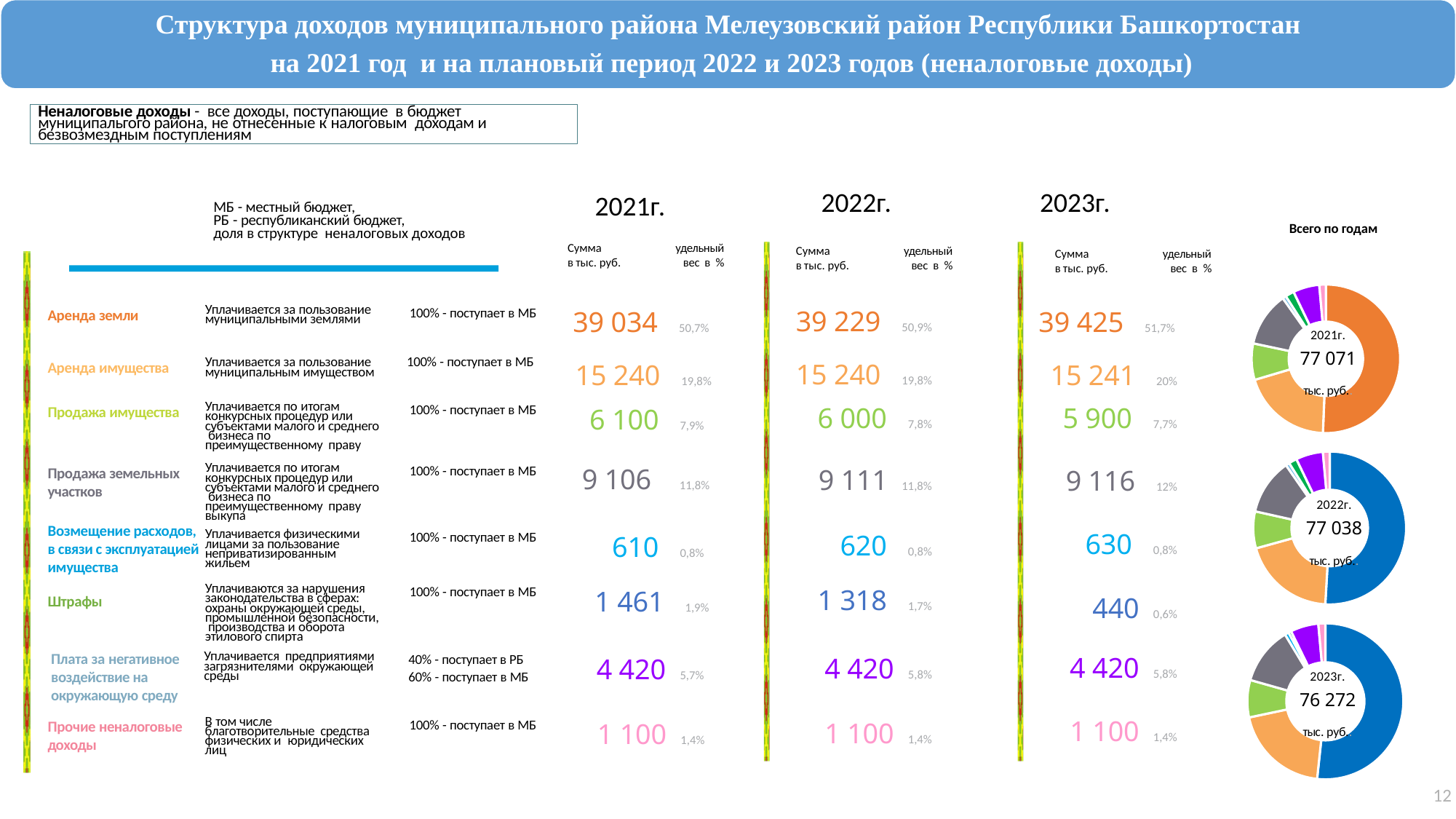
What is the difference between the centre totals of the 2021г. and 2023г. donut charts? 799 How many donut charts are shown under 'Всего по годам'? 3 In the 2021г. donut chart, which revenue category does the largest (orange) slice represent, according to the table? Аренда земли Is the centre total of the 2022г. donut chart greater or less than the centre total of the 2023г. donut chart? greater What kind of chart is used in the 'Всего по годам' section on the right of the slide? Pie (donut) chart What share of non-tax revenue does 'Аренда земли' make up in 2021г., as shown on the slide? 50,7% In the 2021г. donut chart, what total value is printed in the centre? 77 071 тыс. руб. Which year's donut chart shows the lowest total in its centre? 2023г. In the 2022г. donut chart, what total value is printed in the centre? 77 038 тыс. руб. Which year's donut chart shows the highest total in its centre? 2021г. In the 2023г. donut chart, what total value is printed in the centre? 76 272 тыс. руб. What is the difference between the centre totals of the 2021г. and 2022г. donut charts? 33